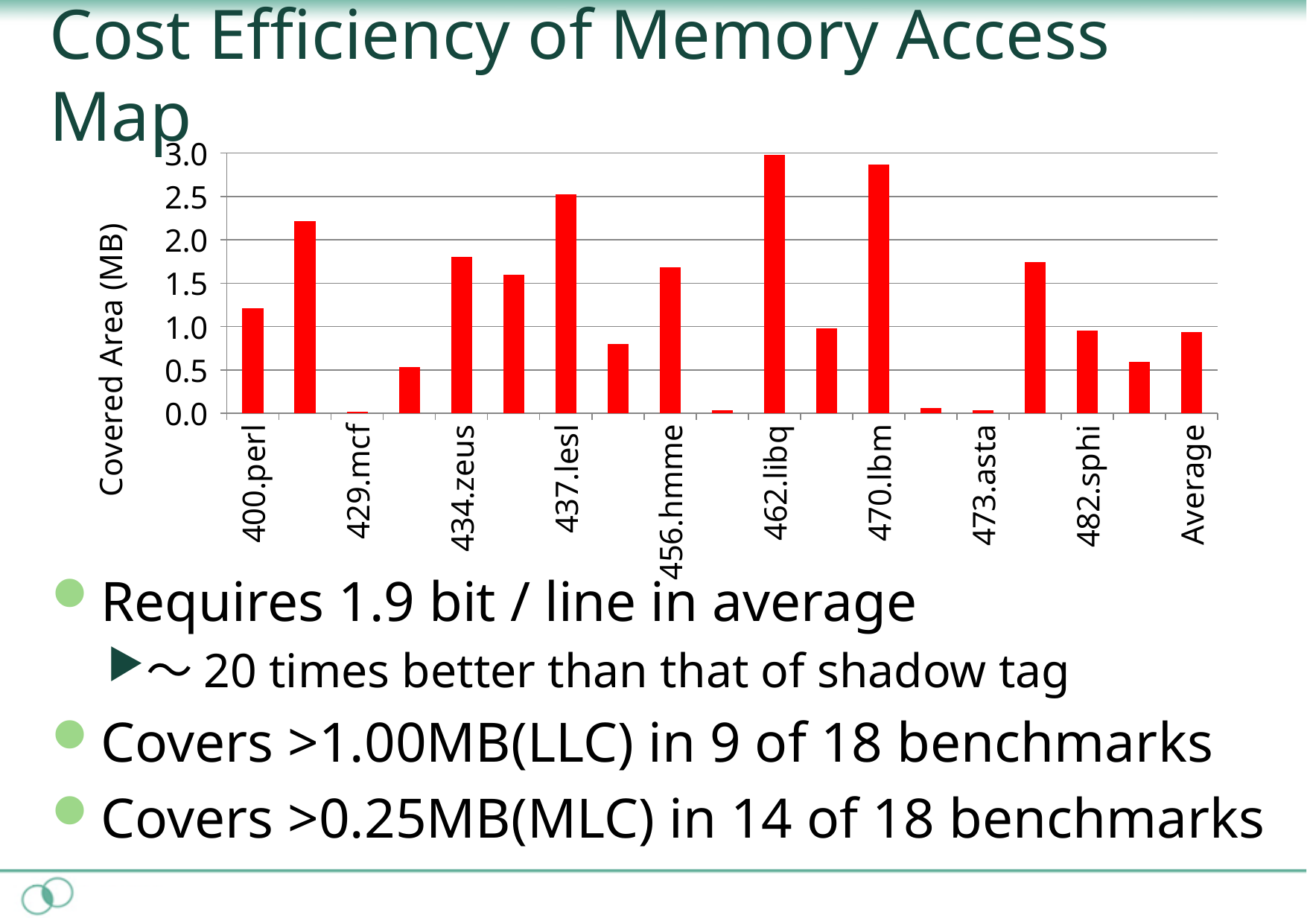
Which has a larger covered area, 400.perl or 434.zeus? 434.zeus Is the value for 400.perl greater or less than 1.0? greater How many bars are plotted in the chart? 19 Is the value for Average greater or less than 1.5? less Which labelled benchmark has the highest covered area in the chart? 462.libq Is the value for 470.lbm greater or less than 2.5? greater What kind of chart is shown on the slide? bar chart What colour are the bars in the chart? red What is the label of the vertical axis of the chart? Covered Area (MB)